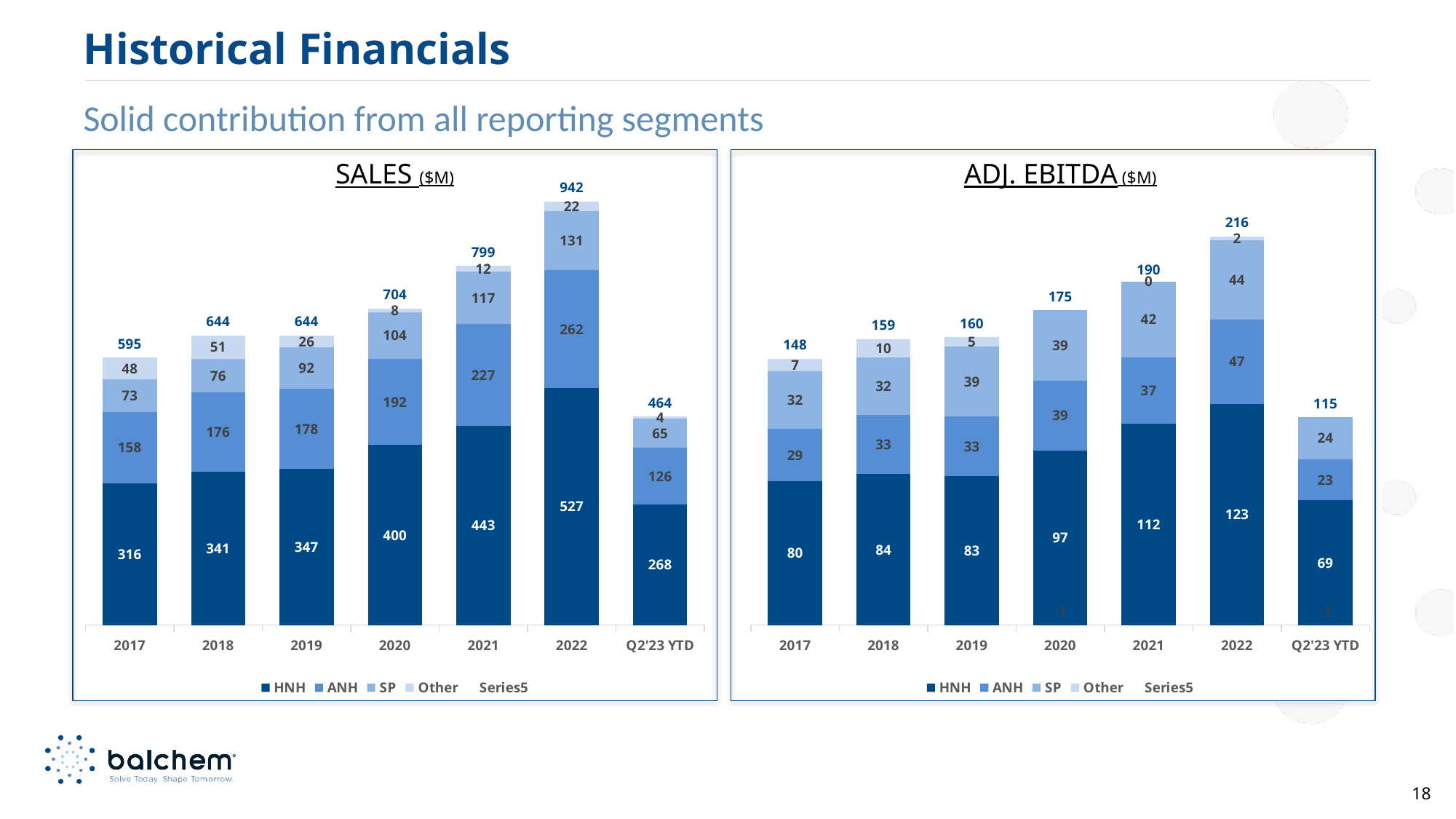
In the SALES ($M) chart, what is the total sales value shown above the 2020 bar? 704 How many categories are shown on the x axis of the SALES ($M) chart? 7 In the SALES ($M) chart, what is the HNH value for 2022? 527 In the SALES ($M) chart, do the total sales values rise or fall from 2019 to 2022? rise What kind of chart is the SALES ($M) chart? Stacked bar chart In the ADJ. EBITDA ($M) chart, is the HNH value for 2022 larger or smaller than the HNH value for 2021? larger In the SALES ($M) chart, what is the difference between the ANH values for 2021 and 2020? 35 How many series does the legend of the ADJ. EBITDA ($M) chart list? 5 In the SALES ($M) chart, which year has the highest total sales? 2022 In the ADJ. EBITDA ($M) chart, what is the total shown above the 2019 bar? 160 In the ADJ. EBITDA ($M) chart, what is the SP value for 2021? 42 In the ADJ. EBITDA ($M) chart, which full year (2017–2022) has the lowest total? 2017